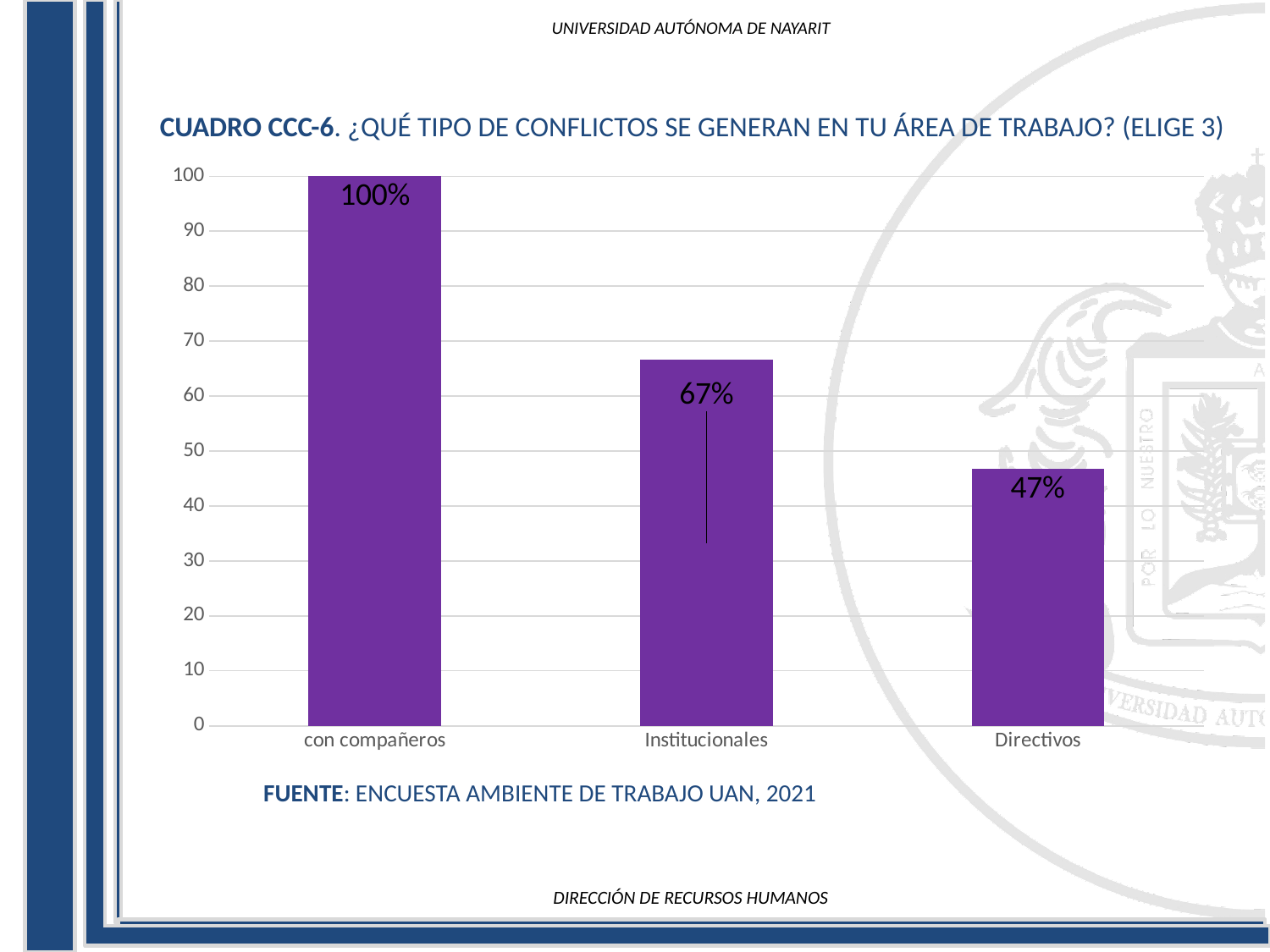
What is the difference between the values for Institucionales and Directivos? 20% What is the value for con compañeros? 100% Which category has the lowest value? Directivos What is the value for Institucionales? 67% What is the difference between the values for con compañeros and Institucionales? 33% What kind of chart is shown on the slide? bar chart Which is larger, the value for Institucionales or the value for Directivos? Institucionales Do the values rise or fall from left to right along the x axis? fall How many categories are shown on the x axis? 3 Which category has the highest value? con compañeros Is the value for Directivos greater or less than 50? less What is the value for Directivos? 47%